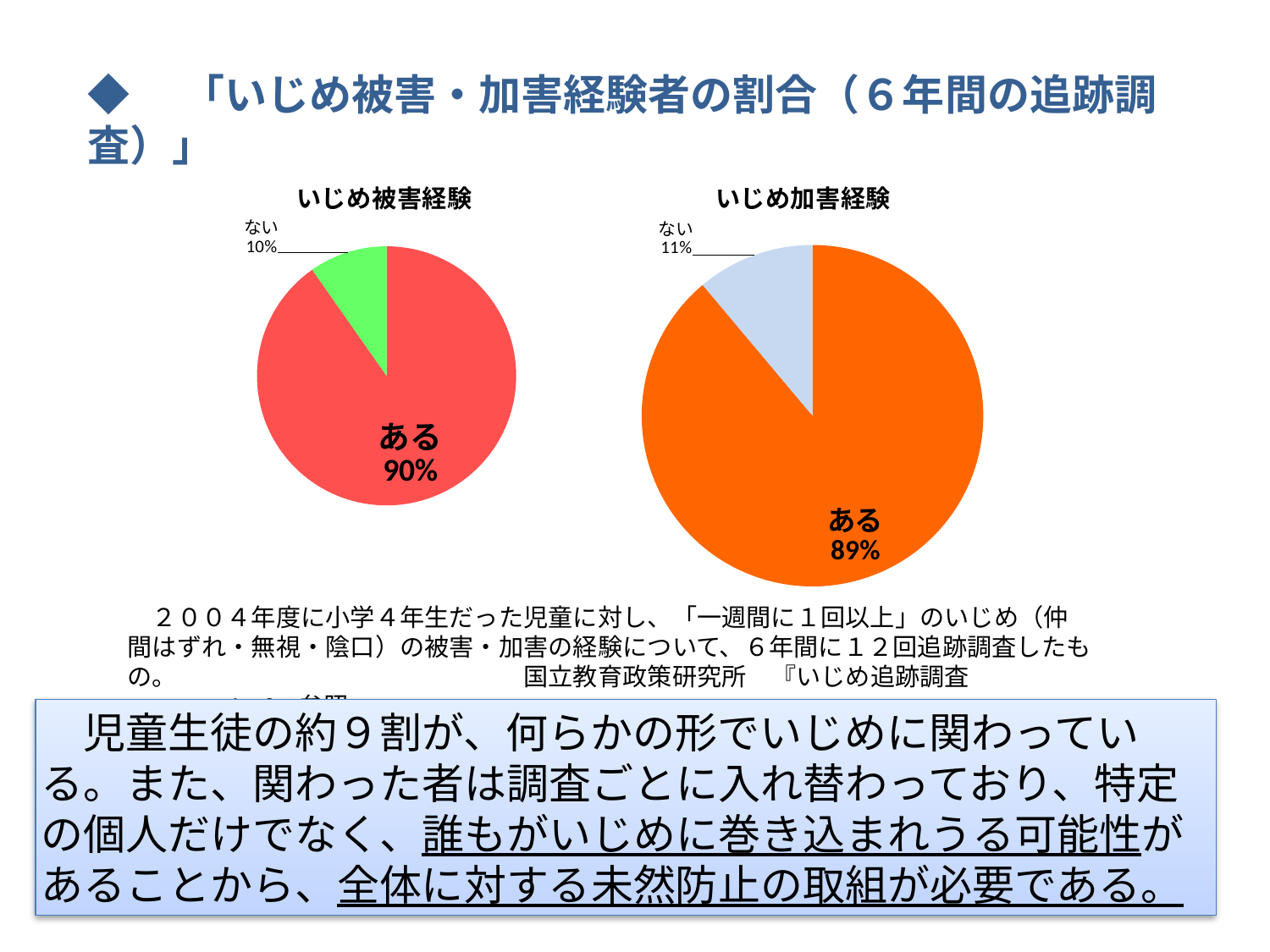
In the いじめ被害経験 chart, what share is labelled ある? 90% In the いじめ被害経験 chart, what is the difference between the ある and ない shares? 80% In the いじめ被害経験 chart, what share is labelled ない? 10% How many pie charts are shown on the slide? 2 In the いじめ被害経験 chart, which slice is the largest? ある What kind of chart is the いじめ被害経験 chart? Pie chart What is the title of the chart on the right? いじめ加害経験 In the いじめ加害経験 chart, what share is labelled ある? 89% Which is larger: the ない share in the いじめ被害経験 chart or the ない share in the いじめ加害経験 chart? いじめ加害経験 How many slices does the いじめ加害経験 chart have? 2 In the いじめ加害経験 chart, what share is labelled ない? 11% In the いじめ加害経験 chart, which slice is the smallest? ない